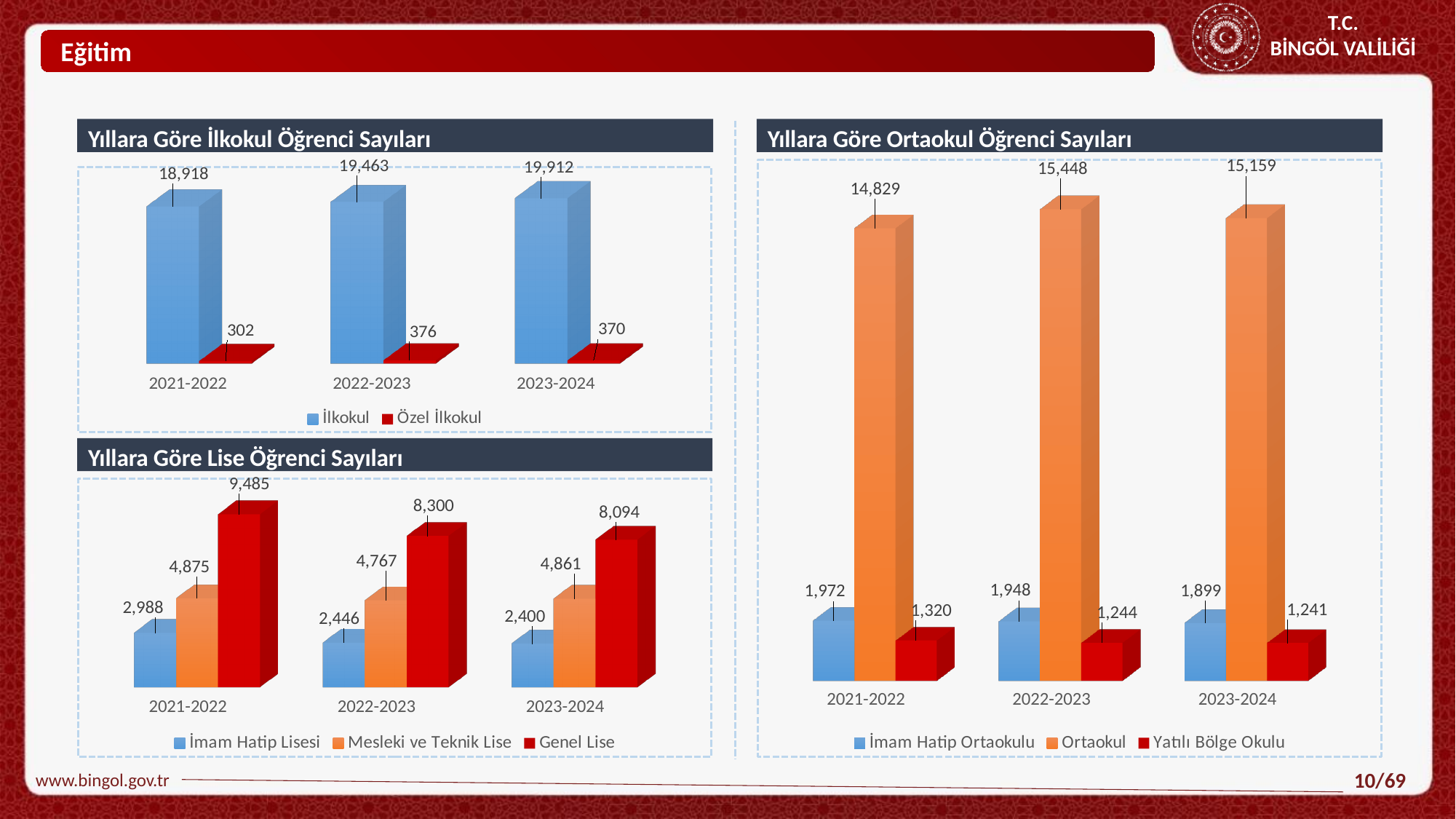
In the 'Yıllara Göre İlkokul Öğrenci Sayıları' chart, what is the difference between the İlkokul values for 2023-2024 and 2021-2022? 994 In the 'Yıllara Göre Ortaokul Öğrenci Sayıları' chart, what is the value for Ortaokul in 2022-2023? 15,448 In the 'Yıllara Göre Ortaokul Öğrenci Sayıları' chart, which year has the highest Ortaokul value? 2022-2023 In the 'Yıllara Göre Lise Öğrenci Sayıları' chart, which year has the lowest İmam Hatip Lisesi value? 2023-2024 In the 'Yıllara Göre Lise Öğrenci Sayıları' chart, what is the difference between Genel Lise and Mesleki ve Teknik Lise in 2023-2024? 3,233 In the 'Yıllara Göre İlkokul Öğrenci Sayıları' chart, what is the value for İlkokul in 2023-2024? 19,912 In the 'Yıllara Göre Ortaokul Öğrenci Sayıları' chart, which is larger in 2021-2022: İmam Hatip Ortaokulu or Yatılı Bölge Okulu? İmam Hatip Ortaokulu In the 'Yıllara Göre İlkokul Öğrenci Sayıları' chart, does the İlkokul value rise or fall from 2021-2022 to 2023-2024? rise In the 'Yıllara Göre İlkokul Öğrenci Sayıları' chart, what is the value for Özel İlkokul in 2021-2022? 302 In the 'Yıllara Göre Lise Öğrenci Sayıları' chart, what is the value for Genel Lise in 2021-2022? 9,485 In the 'Yıllara Göre Lise Öğrenci Sayıları' chart, how many series does the legend list? 3 What kind of chart is 'Yıllara Göre Ortaokul Öğrenci Sayıları'? bar chart